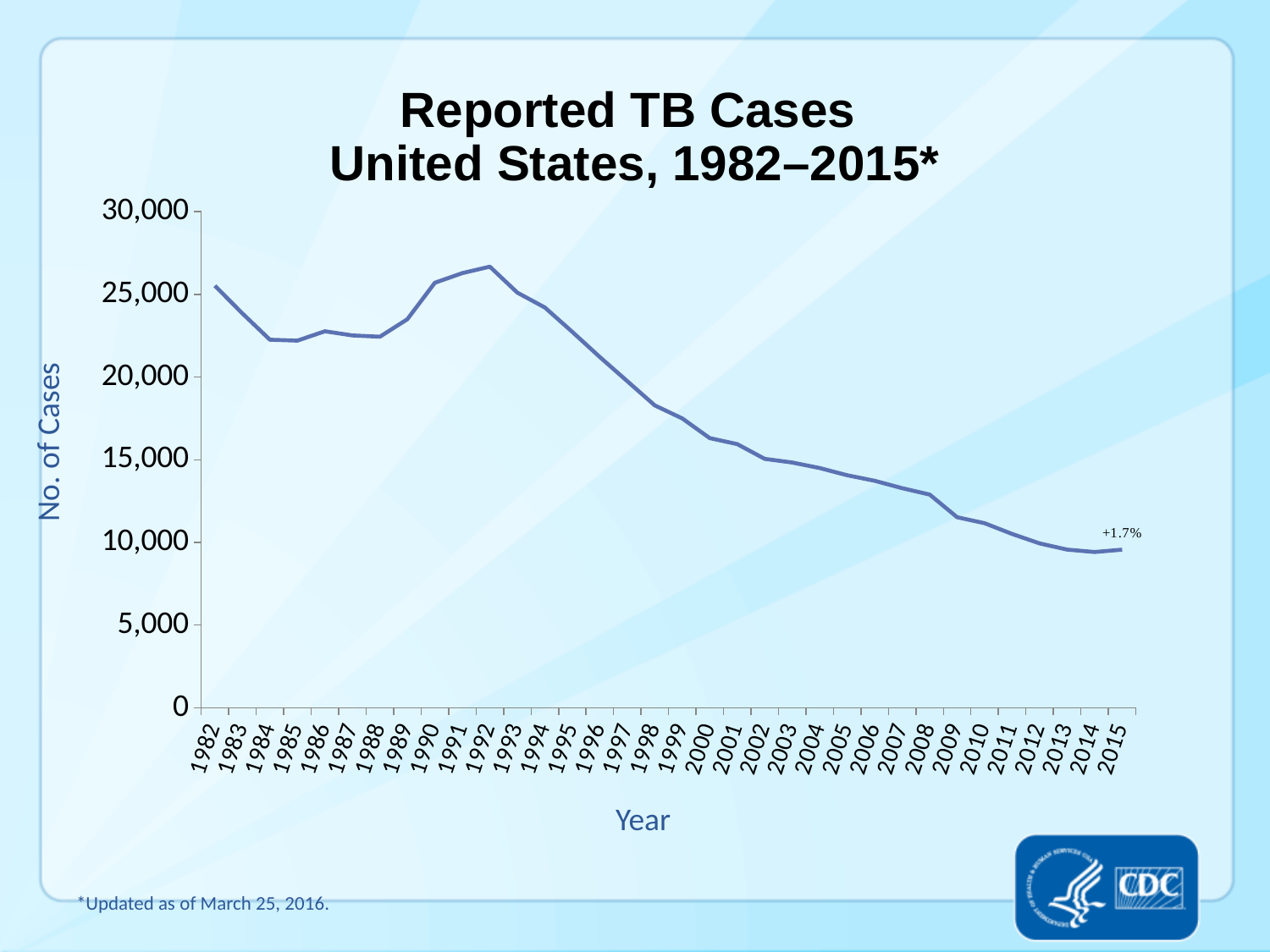
What is the title of the chart? Reported TB Cases United States, 1982–2015* In which year is the number of reported TB cases highest? 1992 What percentage change is annotated next to the 2015 data point? +1.7% Which year has more reported TB cases, 1992 or 2015? 1992 Is the value for 1998 greater or less than 20,000? less How many years are plotted along the x axis? 34 Is the value for 1992 greater or less than 25,000? greater Do the values rise or fall from 1992 to 2015? fall Which year has more reported TB cases, 1990 or 1984? 1990 Is the value for 2015 greater or less than 10,000? less What kind of chart is shown on the slide? Line chart